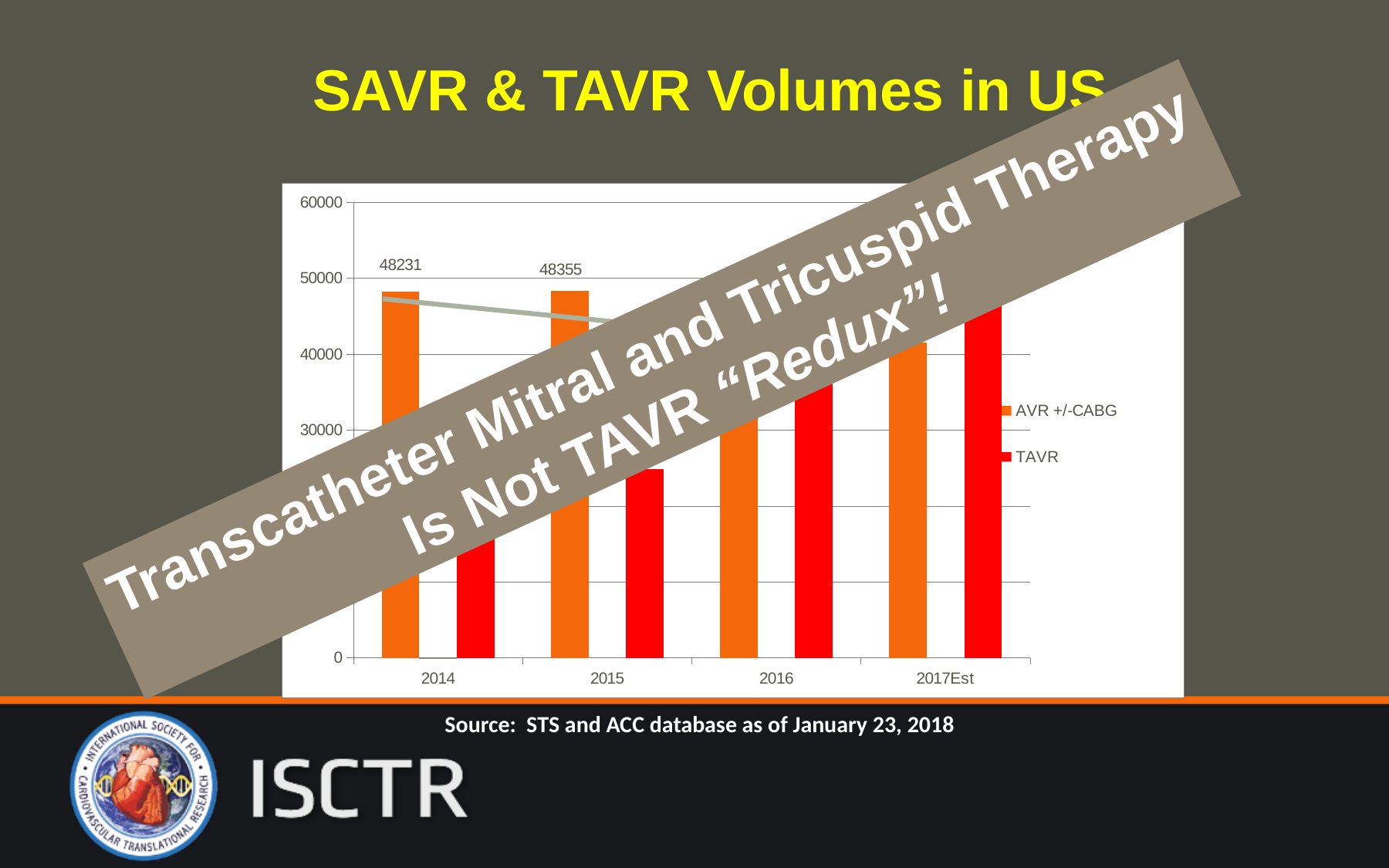
How many series does the legend list? 2 Is the TAVR value for 2015 greater or less than 30000? less Is the TAVR value for 2017Est greater or less than 40000? greater Do the TAVR values rise or fall from 2014 to 2017Est? rise In 2014, which series has the larger value, AVR +/-CABG or TAVR? AVR +/-CABG How many year categories are shown on the x axis? 4 What type of chart is shown on the slide? bar chart What is the title of the chart? SAVR & TAVR Volumes in US What is the AVR +/-CABG value for 2014? 48231 What is the AVR +/-CABG value for 2015? 48355 What is the difference between the AVR +/-CABG values for 2015 and 2014? 124 Which is larger, the AVR +/-CABG value for 2014 or for 2015? 2015